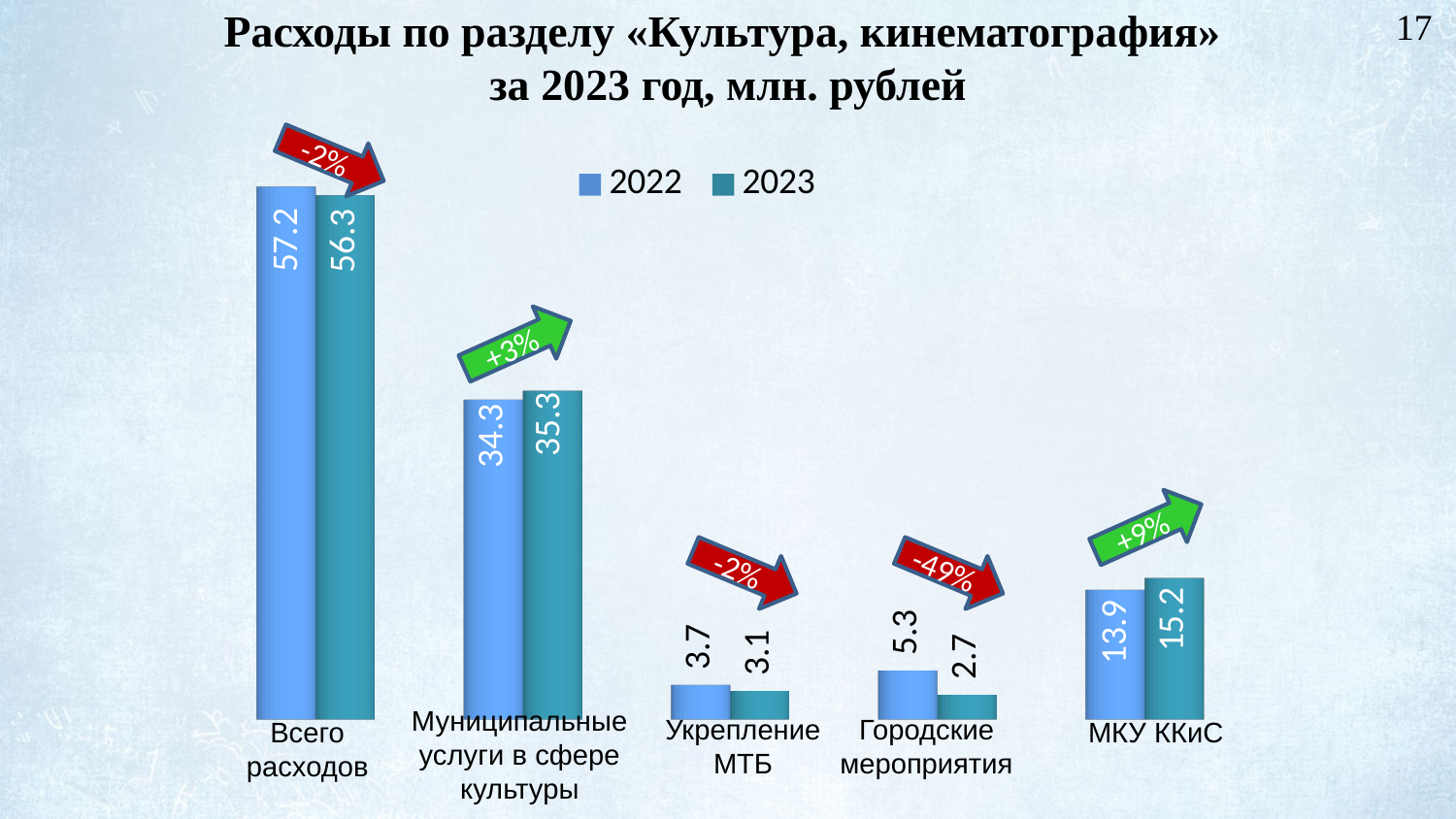
What is the difference between the 2022 and 2023 values for «Городские мероприятия»? 2.6 How many categories are shown on the chart? 5 For «Укрепление МТБ», which year has the larger value, 2022 or 2023? 2022 What is the 2023 value for «Городские мероприятия»? 2.7 What is the difference between the 2023 and 2022 values for «МКУ ККиС»? 1.3 What is the 2022 value for «Муниципальные услуги в сфере культуры»? 34.3 Which category has the highest 2022 value? Всего расходов What is the 2022 value for «МКУ ККиС»? 13.9 What kind of chart is shown on the slide? Bar chart How many series does the legend list? 2 Which category has the lowest 2023 value? Городские мероприятия What is the 2023 value for «Всего расходов»? 56.3